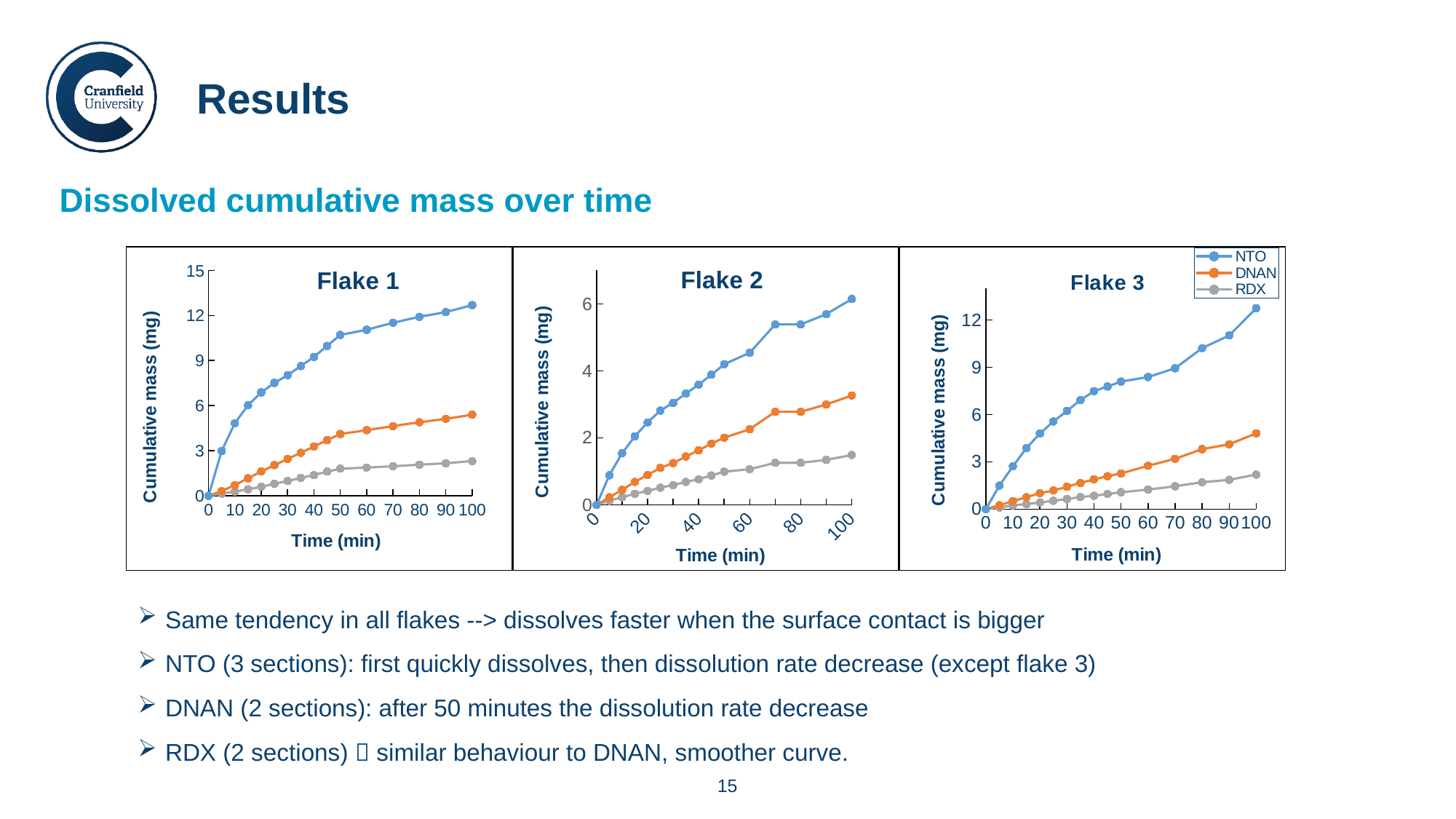
What is the y-axis label on the Flake 2 chart? Cumulative mass (mg) In the Flake 3 chart, is the DNAN value at 100 min greater or less than 3? greater In the Flake 2 chart, which series has the lowest cumulative mass at 100 min? RDX In the Flake 1 chart, is the NTO value at 100 min greater or less than 12? greater In the Flake 3 chart, is the RDX value at 100 min greater or less than 3? less In the Flake 1 chart, which series has the highest cumulative mass at 100 min? NTO What kind of chart is the Flake 1 chart? line chart In the Flake 1 chart, at 50 min, which is larger: NTO or DNAN? NTO How many series does the legend list for the charts? 3 In the Flake 3 chart, does the NTO series rise or fall as time increases? rise